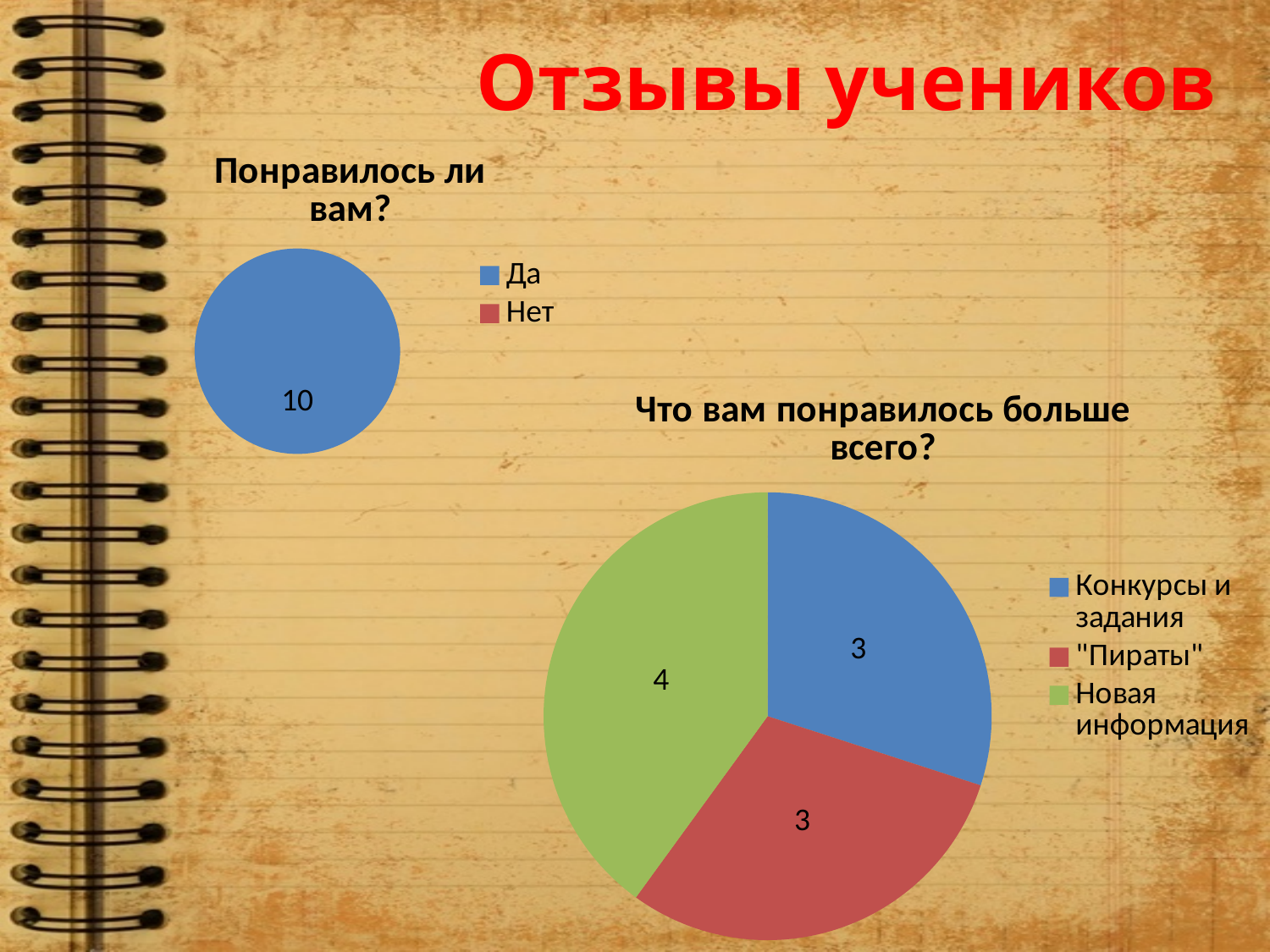
In the chart titled "Что вам понравилось больше всего?", which category has the largest slice? Новая информация How many slices does the chart titled "Что вам понравилось больше всего?" have? 3 In the chart titled "Что вам понравилось больше всего?", what value is shown for "Конкурсы и задания"? 3 In the chart titled "Что вам понравилось больше всего?", what value is shown for "Пираты"? 3 In the chart titled "Что вам понравилось больше всего?", what value is shown for "Новая информация"? 4 In the chart titled "Что вам понравилось больше всего?", what colour is the slice for "Пираты"? Red In the chart titled "Что вам понравилось больше всего?", which is larger: "Новая информация" or "Конкурсы и задания"? Новая информация In the chart titled "Что вам понравилось больше всего?", what share of the total does "Новая информация" represent? 40% How many entries does the legend of the chart titled "Понравилось ли вам?" list? 2 In the chart titled "Что вам понравилось больше всего?", what is the difference between the values for "Новая информация" and "Пираты"? 1 What kind of chart is the chart titled "Понравилось ли вам?"? Pie chart In the chart titled "Понравилось ли вам?", what value is shown for "Да"? 10